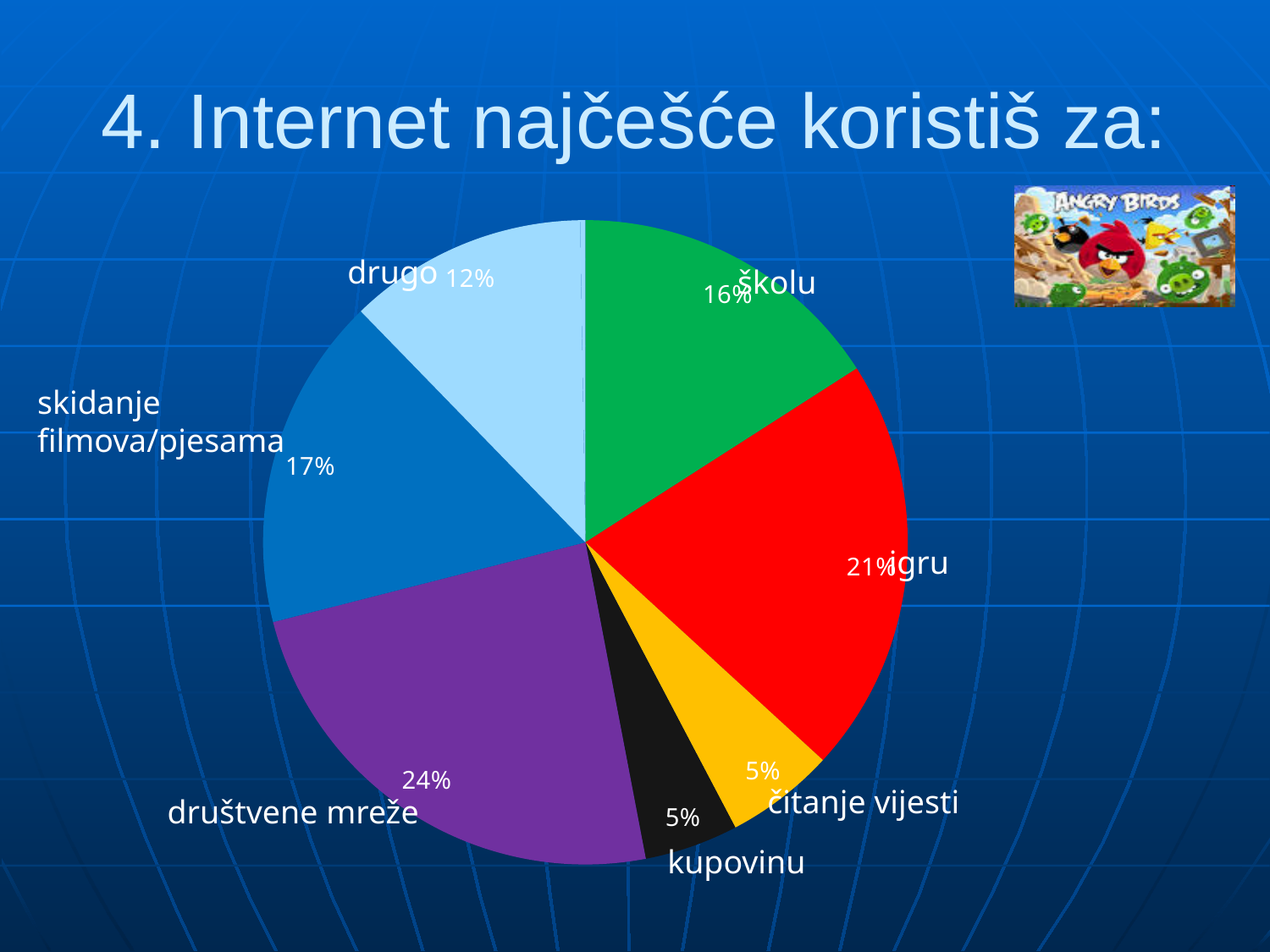
What is the difference between the shares for "društvene mreže" and "igru"? 3% Which category has the largest slice of the pie? društvene mreže What is the title of the slide containing the pie chart? 4. Internet najčešće koristiš za: What percentage of the pie is labelled "skidanje filmova/pjesama"? 17% What is the combined share of "čitanje vijesti" and "kupovinu"? 10% What percentage of the pie is labelled "društvene mreže"? 24% What percentage of the pie is labelled "igru"? 21% Which is larger, the share for "školu" or the share for "drugo"? školu How many slices does the pie chart have? 7 What kind of chart is shown on the slide? pie chart What percentage of the pie is labelled "drugo"? 12% What percentage of the pie is labelled "školu"? 16%